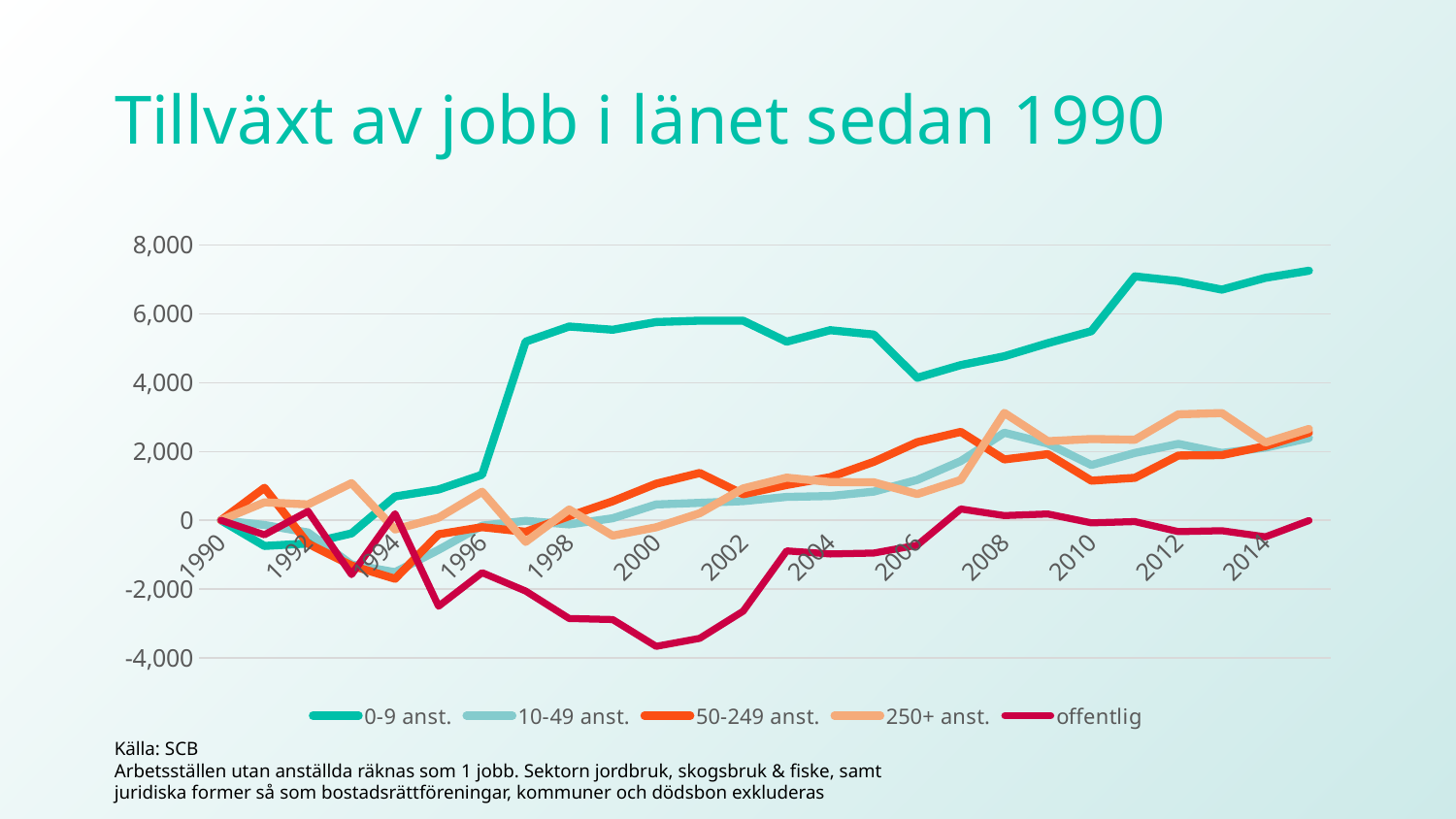
What is the title of the chart? Tillväxt av jobb i länet sedan 1990 Which series has the lowest value in 2000? offentlig Is the value for 250+ anst. in 2012 greater or less than 2,000? greater What source is cited below the chart? SCB How many series does the legend list? 5 Which series has the highest value in 2014? 0-9 anst. Is the value for 0-9 anst. in 1996 greater or less than 2,000? less What kind of chart is shown on the slide? line chart In 2006, which is larger: the value for 0-9 anst. or the value for offentlig? 0-9 anst. Does the 0-9 anst. series overall rise or fall from 1990 to 2014? rise Is the value for 0-9 anst. in 2014 greater or less than 6,000? greater